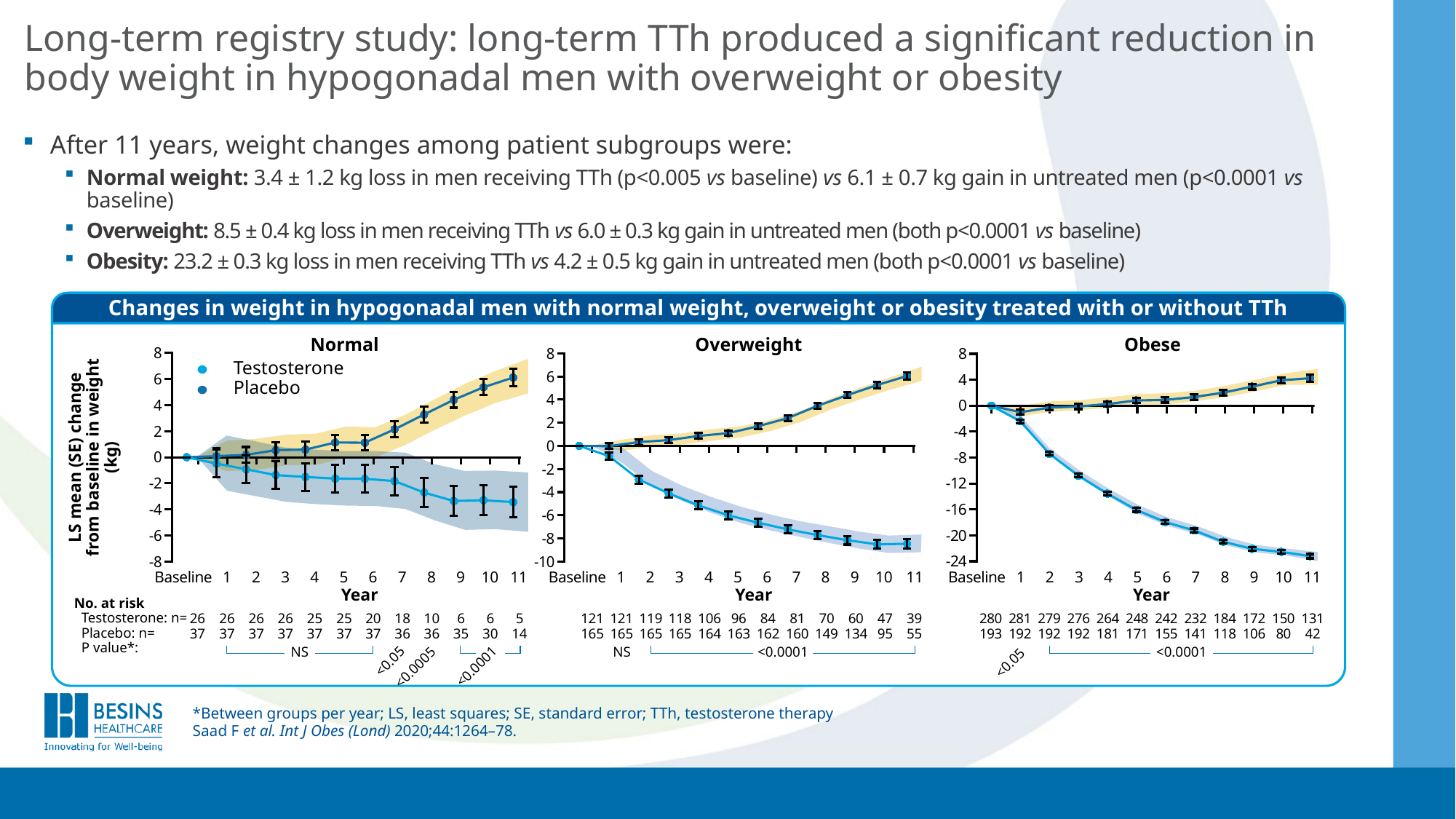
In the Obese panel, does the Testosterone line rise or fall from Baseline to year 11? fall In the Obese panel, which series has the higher value at year 11, Testosterone or Placebo? Placebo What kind of chart is the Normal panel? line chart In the Obese panel, what is the number at risk for Testosterone at Baseline? 280 In the Overweight panel, does the Placebo line rise or fall from Baseline to year 11? rise In the Overweight panel, is the Testosterone value at year 11 greater or less than -6? less In the Overweight panel, how many time points are shown on the x axis (including Baseline)? 12 In the Overweight panel, is the Placebo value at year 11 greater or less than 4? greater How many series does the legend in the Normal panel list? 2 In the Overweight panel, what is the number at risk for Placebo at year 11? 55 What is the title of the figure containing the three panels? Changes in weight in hypogonadal men with normal weight, overweight or obesity treated with or without TTh In the Obese panel, is the Testosterone value at year 11 greater or less than -20? less